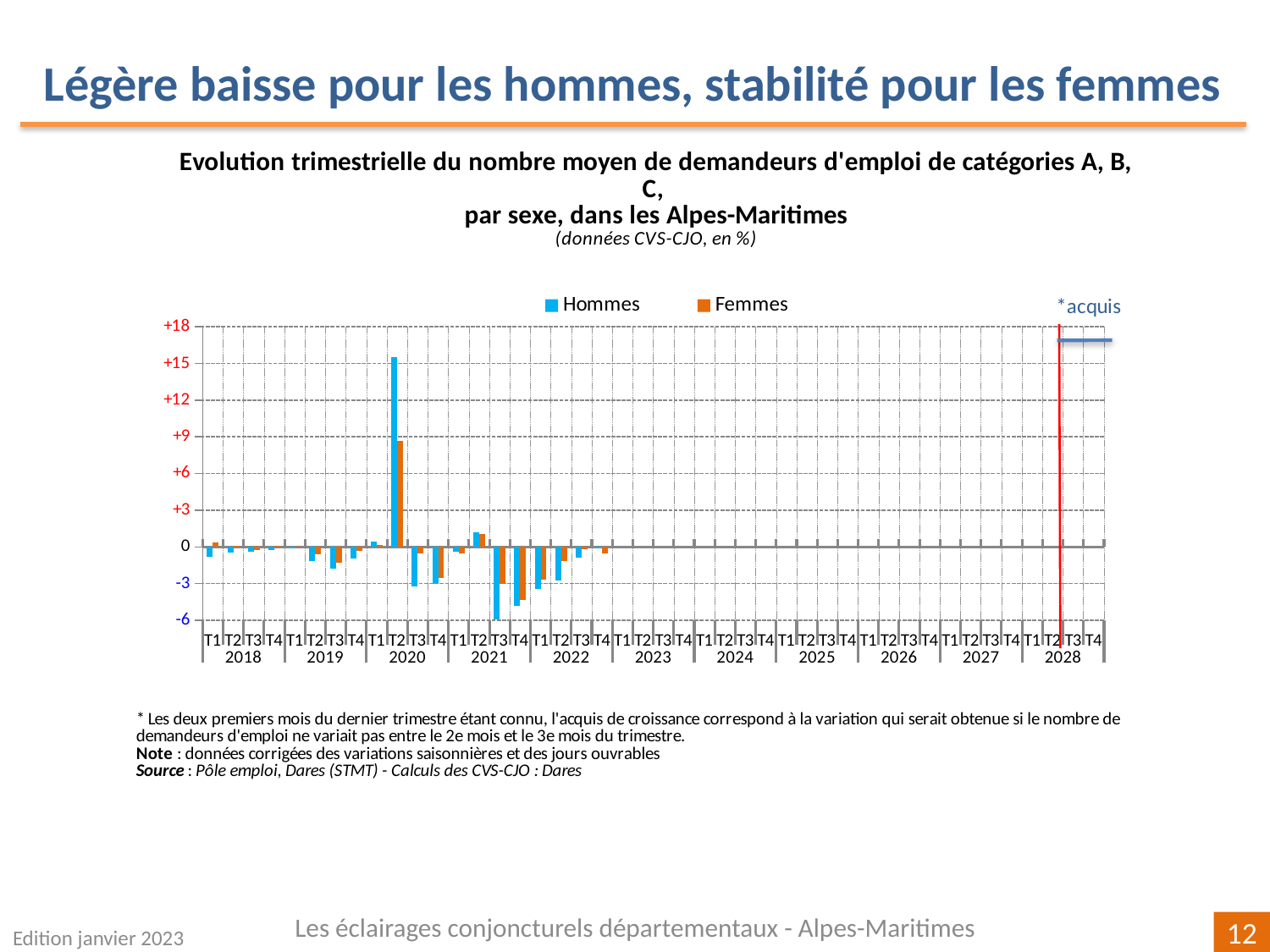
Is the Femmes value for T2 2020 greater or less than +6? greater Which colour represents the Femmes series? orange How many series does the legend list? 2 How many years are labelled along the horizontal axis? 11 Which two series are listed in the legend? Hommes and Femmes Is the Hommes value for T3 2020 greater or less than 0? less What kind of chart is shown on the slide? bar chart Is the Hommes value for T3 2021 greater or less than -3? less What is the highest value shown on the vertical axis? +18 In T2 2020, which series has the larger value, Hommes or Femmes? Hommes In which quarter does the Hommes series reach its highest value? T2 2020